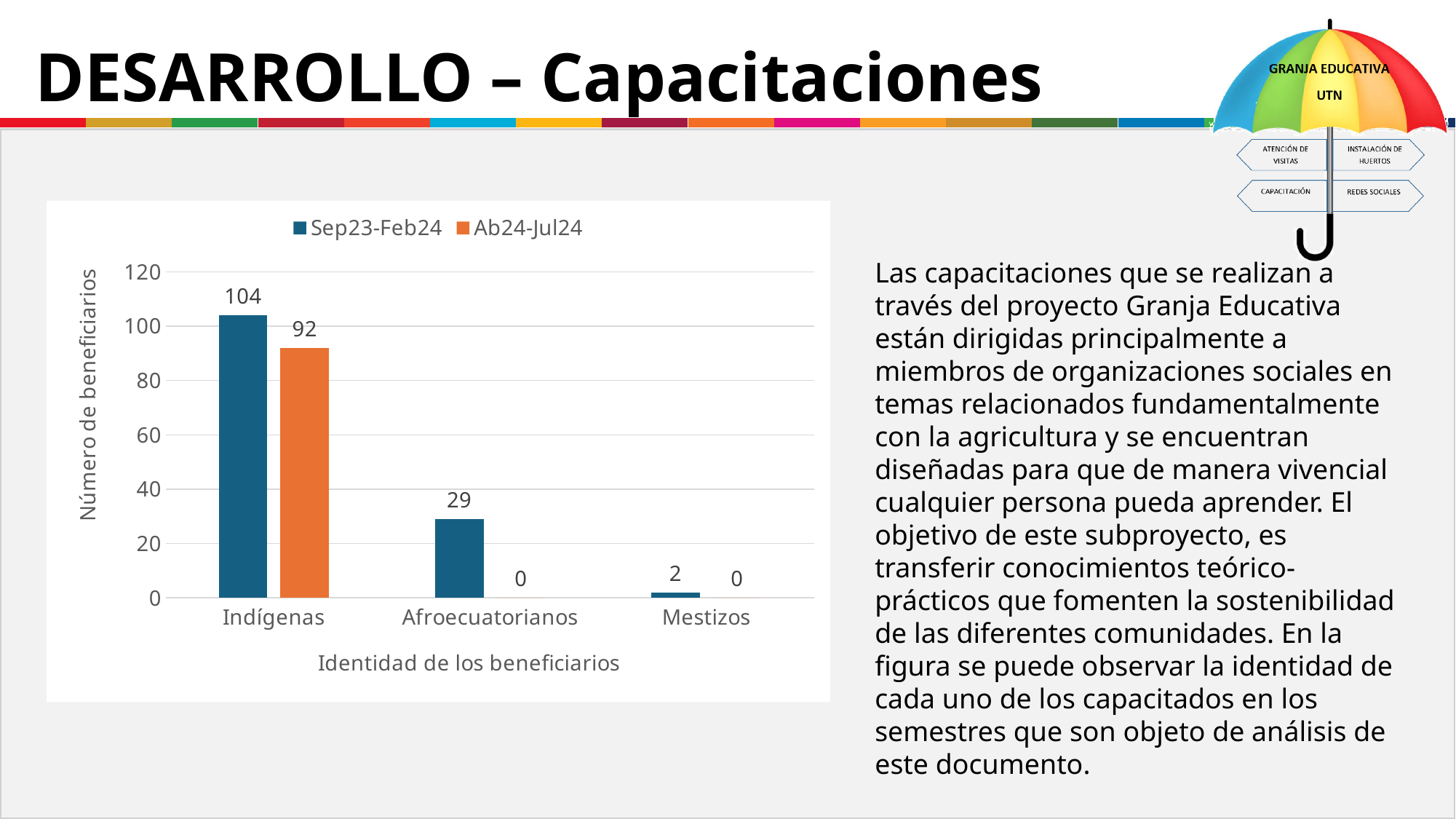
What is the value for Afroecuatorianos in the Sep23-Feb24 series? 29 Which is larger for Indígenas: the Sep23-Feb24 value or the Ab24-Jul24 value? Sep23-Feb24 What kind of chart is shown on the slide? Bar chart What is the value for Afroecuatorianos in the Ab24-Jul24 series? 0 Which category has the lowest value in the Sep23-Feb24 series? Mestizos How many series does the legend list? 2 Which category has the highest value in the Sep23-Feb24 series? Indígenas What is the value for Indígenas in the Ab24-Jul24 series? 92 What is the value for Indígenas in the Sep23-Feb24 series? 104 What is the value for Mestizos in the Sep23-Feb24 series? 2 How many categories are shown on the x axis? 3 What is the difference between the Sep23-Feb24 and Ab24-Jul24 values for Indígenas? 12